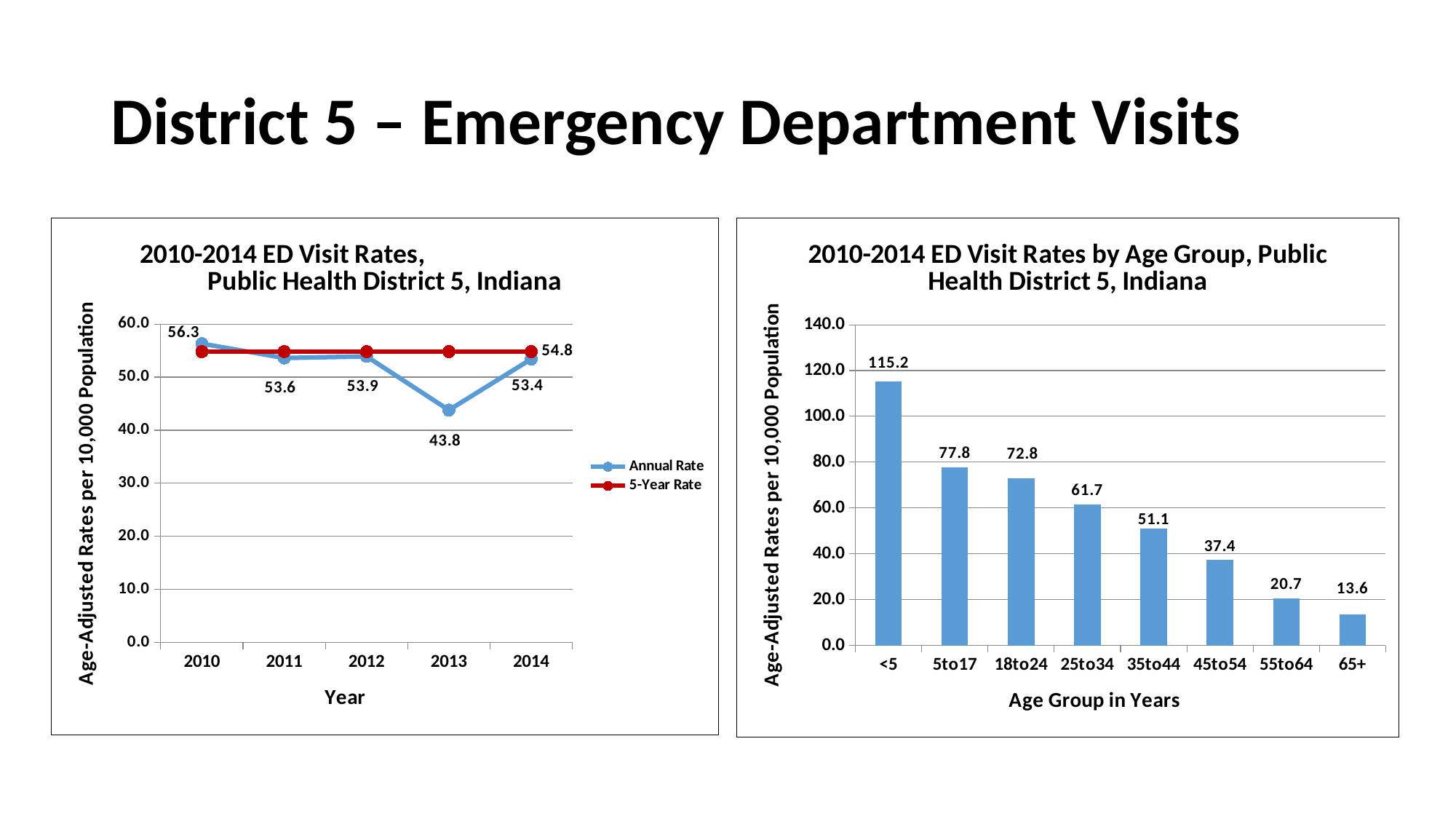
In the left chart (2010-2014 ED Visit Rates, Public Health District 5, Indiana), what is the 5-Year Rate? 54.8 In the left chart (2010-2014 ED Visit Rates, Public Health District 5, Indiana), what is the Annual Rate for 2013? 43.8 In the left chart (2010-2014 ED Visit Rates, Public Health District 5, Indiana), how many series does the legend list? 2 In the left chart (2010-2014 ED Visit Rates, Public Health District 5, Indiana), which year has the highest Annual Rate? 2010 In the right chart (2010-2014 ED Visit Rates by Age Group, Public Health District 5, Indiana), what is the value for the 25to34 age group? 61.7 In the right chart (2010-2014 ED Visit Rates by Age Group, Public Health District 5, Indiana), do the values rise or fall from left to right across the age groups? Fall In the left chart (2010-2014 ED Visit Rates, Public Health District 5, Indiana), what kind of chart is it? Line chart In the right chart (2010-2014 ED Visit Rates by Age Group, Public Health District 5, Indiana), which age group has the highest rate? <5 In the right chart (2010-2014 ED Visit Rates by Age Group, Public Health District 5, Indiana), which age group has the lowest rate? 65+ In the left chart (2010-2014 ED Visit Rates, Public Health District 5, Indiana), which year has the lowest Annual Rate? 2013 In the right chart (2010-2014 ED Visit Rates by Age Group, Public Health District 5, Indiana), how many age groups are shown? 8 In the left chart (2010-2014 ED Visit Rates, Public Health District 5, Indiana), what is the difference between the Annual Rate in 2010 and in 2013? 12.5